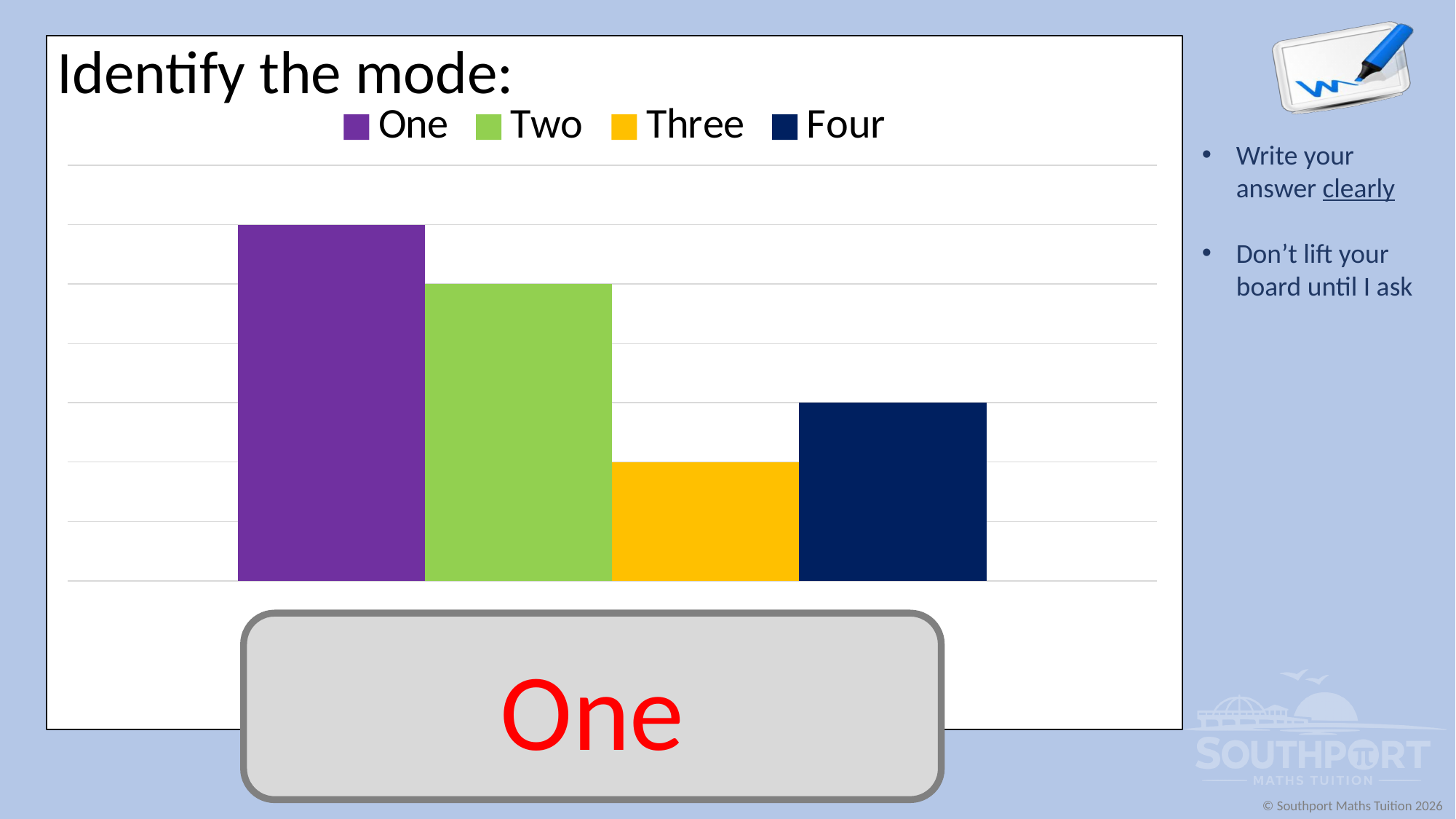
What kind of chart is shown on the slide? bar chart Which series has the tallest bar? One Which bar is taller, Two or Four? Two How many bars are plotted on the chart? 4 How many series does the legend list? 4 Which series has the second tallest bar? Two What colour is the bar for the series Three? yellow Which series has the shortest bar? Three Which series is shown in purple in the legend? One Which bar is taller, One or Two? One Which bar is taller, Three or Four? Four